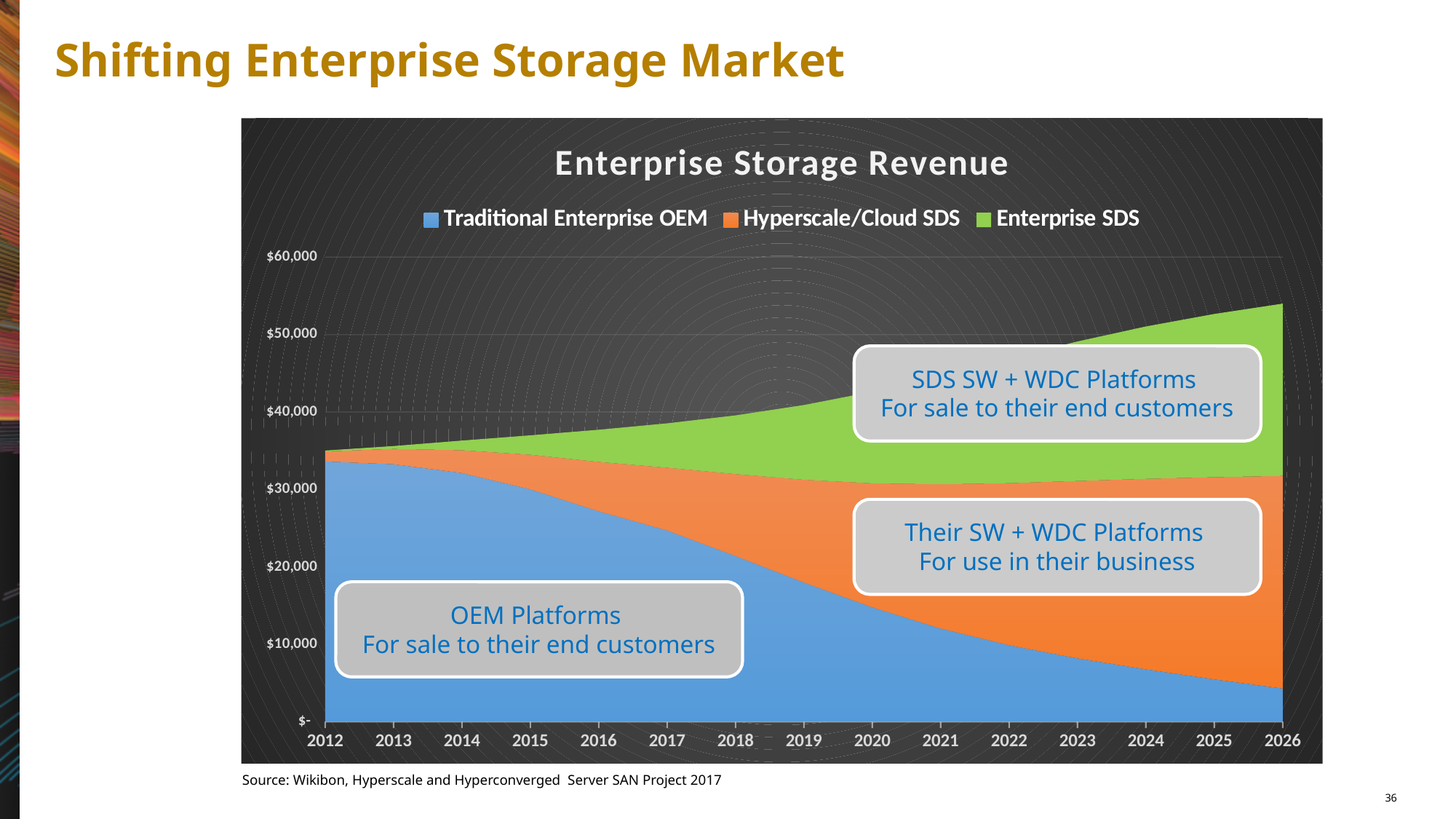
What kind of chart is shown on the slide? stacked area chart Is the Traditional Enterprise OEM value in 2012 greater or less than $30,000? greater Is the total stacked revenue in 2012 greater or less than $40,000? less What is the title of the chart? Enterprise Storage Revenue Does the Traditional Enterprise OEM revenue rise or fall from 2012 to 2026? fall Which is larger in 2012: Traditional Enterprise OEM or Enterprise SDS? Traditional Enterprise OEM How many series does the legend list? 3 Is the total stacked revenue in 2026 greater or less than $50,000? greater Does the total enterprise storage revenue rise or fall from 2012 to 2026? rise How many years are shown along the x axis? 15 Which series is shown in green? Enterprise SDS